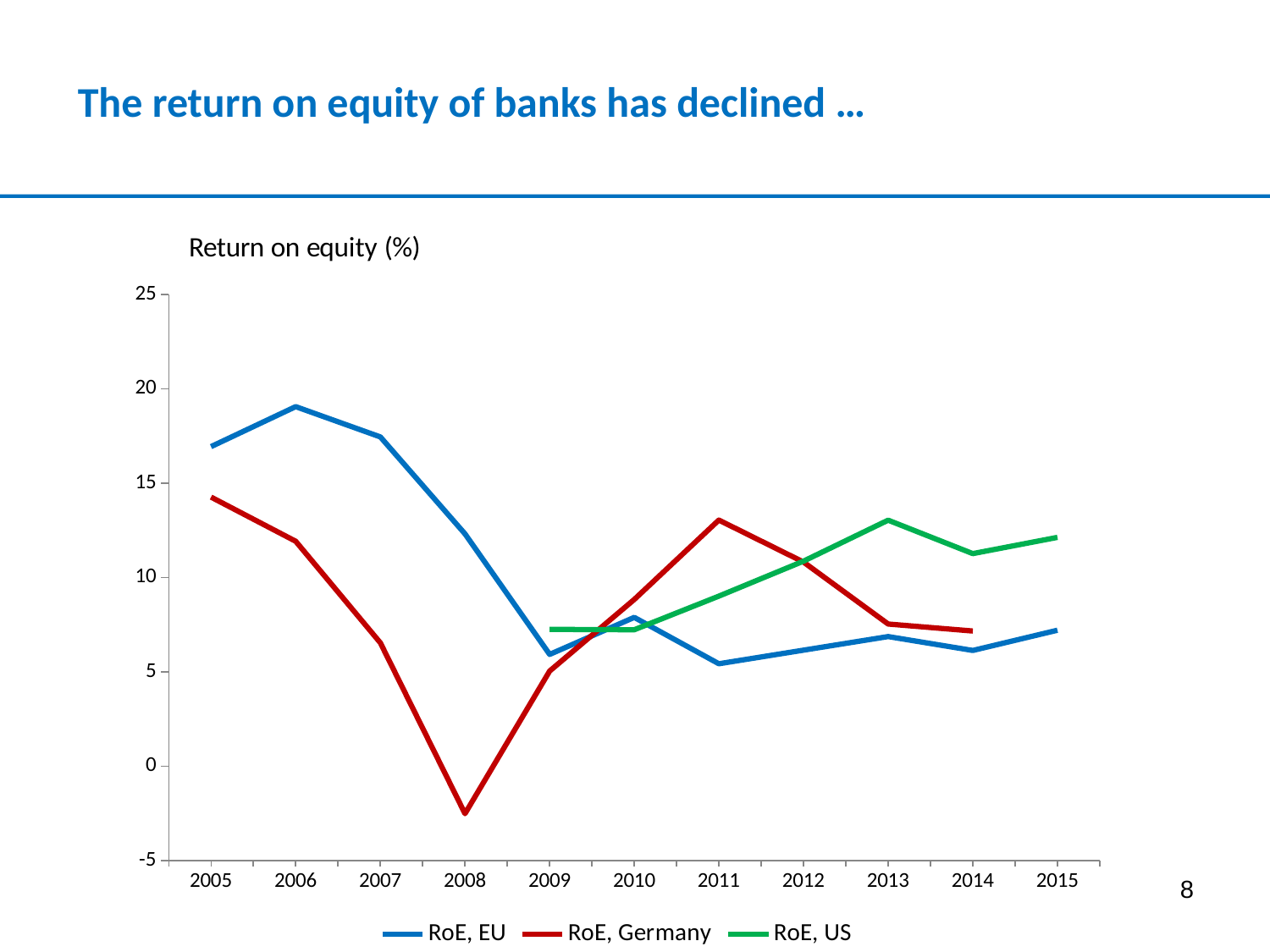
Is the value for RoE, US in 2013 greater or less than 10? greater Is the value for RoE, Germany in 2011 greater or less than 10? greater What is the title of the chart? Return on equity (%) Does RoE, EU rise or fall from 2006 to 2009? fall What kind of chart is shown on the slide? line chart In which year is RoE, EU at its highest? 2006 How many series does the legend list? 3 In which year is RoE, Germany at its lowest? 2008 Is the value for RoE, EU in 2006 greater or less than 15? greater How many years are shown on the x axis? 11 In 2015, which is larger: RoE, US or RoE, EU? RoE, US